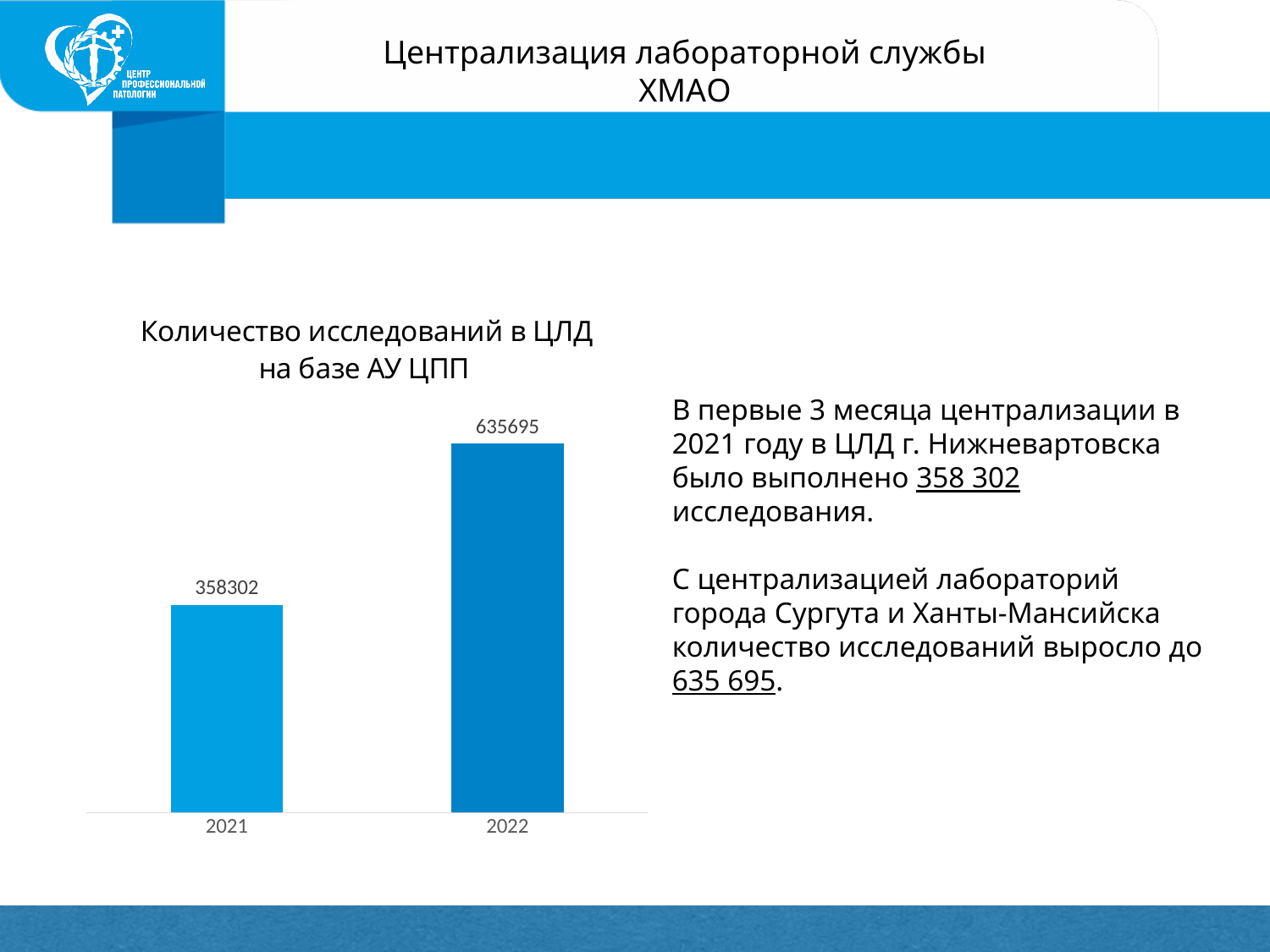
What is the value for 2022 in the chart? 635695 Which is larger, the value for 2021 or the value for 2022? 2022 How many categories are shown on the x axis of the chart? 2 What is the difference between the values for 2022 and 2021? 277393 Which year has the highest value in the chart? 2022 Which year has the lowest value in the chart? 2021 Do the values rise or fall from 2021 to 2022? Rise What is the title of the chart? Количество исследований в ЦЛД на базе АУ ЦПП What kind of chart is shown on the slide? Bar chart What is the total of the values for 2021 and 2022 combined? 993997 What is the value for 2021 in the chart? 358302